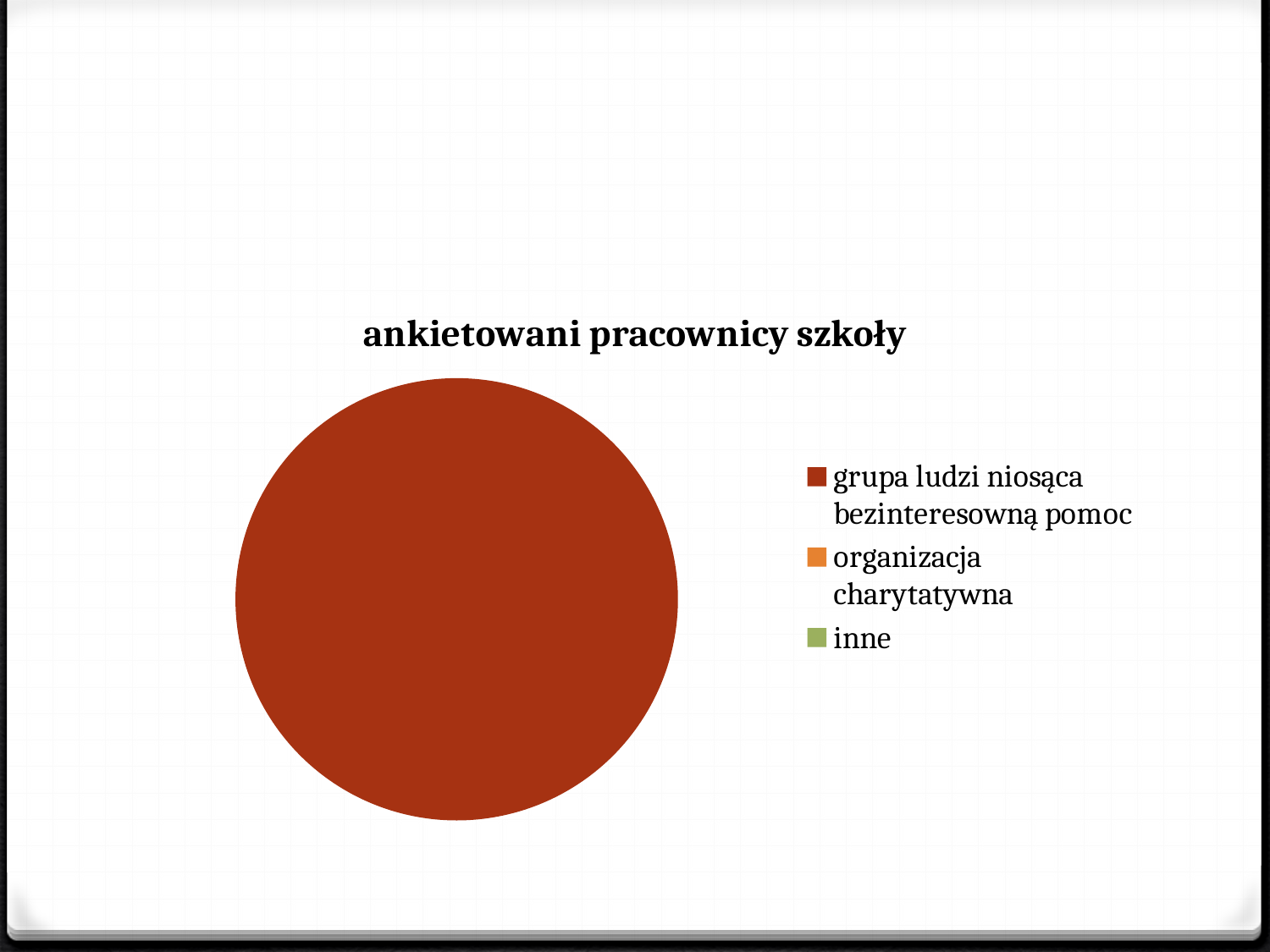
What kind of chart is shown on the slide? pie chart What colour is the slice for "grupa ludzi niosąca bezinteresowną pomoc" in the pie chart? dark red Which is larger in the pie chart: the slice for "grupa ludzi niosąca bezinteresowną pomoc" or the slice for "organizacja charytatywna"? grupa ludzi niosąca bezinteresowną pomoc How many categories does the legend of the chart list? 3 Which is larger in the pie chart: the slice for "inne" or the slice for "grupa ludzi niosąca bezinteresowną pomoc"? grupa ludzi niosąca bezinteresowną pomoc Which category has the largest slice in the pie chart? grupa ludzi niosąca bezinteresowną pomoc What is the title of the chart? ankietowani pracownicy szkoły